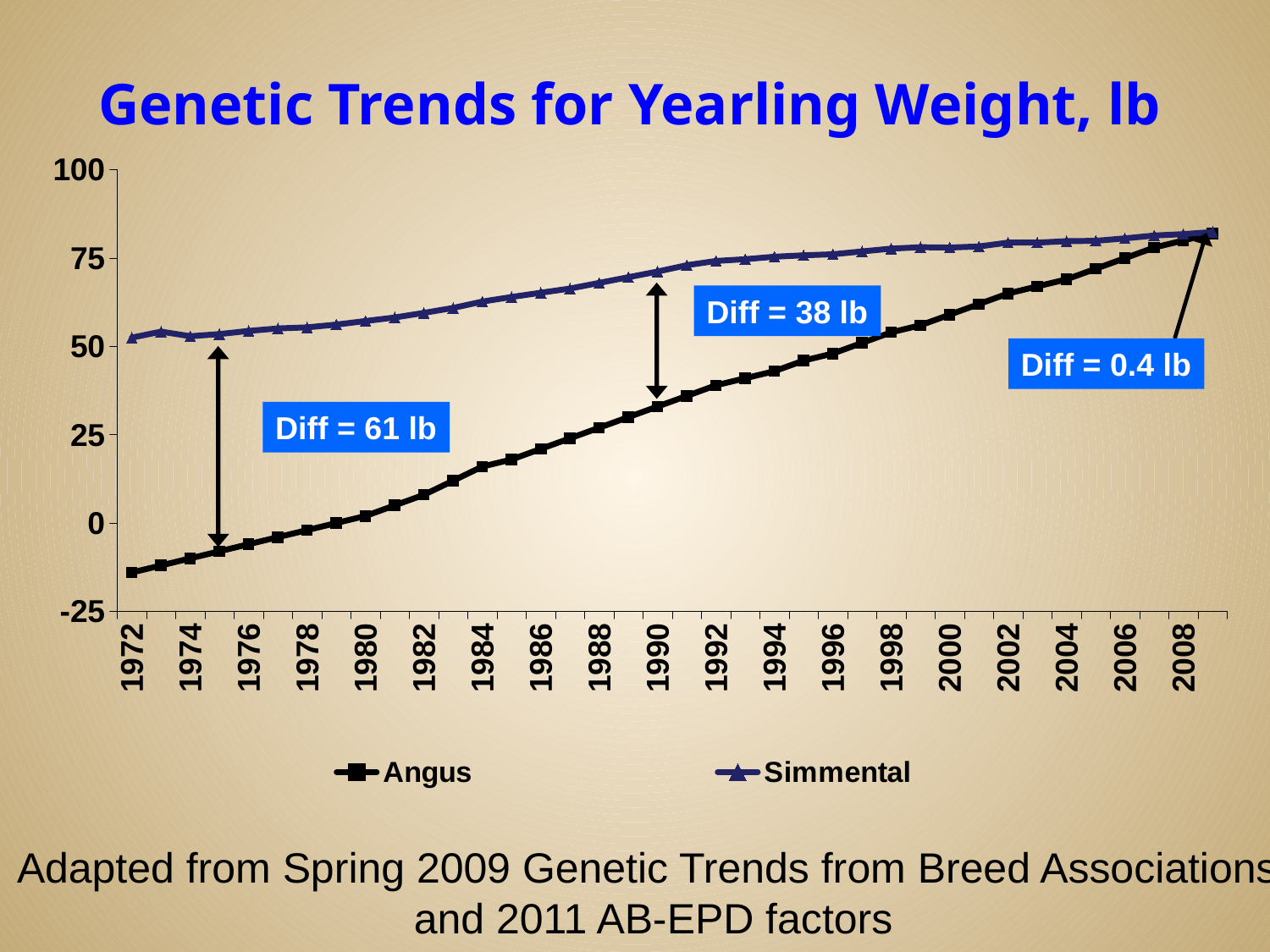
How many series does the legend list? 2 According to the annotation, what is the difference between the Simmental and Angus lines at the end of the series (2009)? 0.4 lb Is the Angus value in 1972 greater or less than 0? less What kind of chart is shown on the slide? line chart What is the title of the chart? Genetic Trends for Yearling Weight, lb How many year labels are shown on the x axis? 19 Which two breeds are listed in the legend? Angus and Simmental Which series has the higher value in 1990, Angus or Simmental? Simmental Is the Simmental value in 1990 greater or less than 50? greater According to the annotation, what is the difference between the Simmental and Angus lines around 1990? 38 lb According to the annotation, what is the difference between the Simmental and Angus lines around 1975? 61 lb Does the Angus line rise or fall from 1972 to 2009? rise